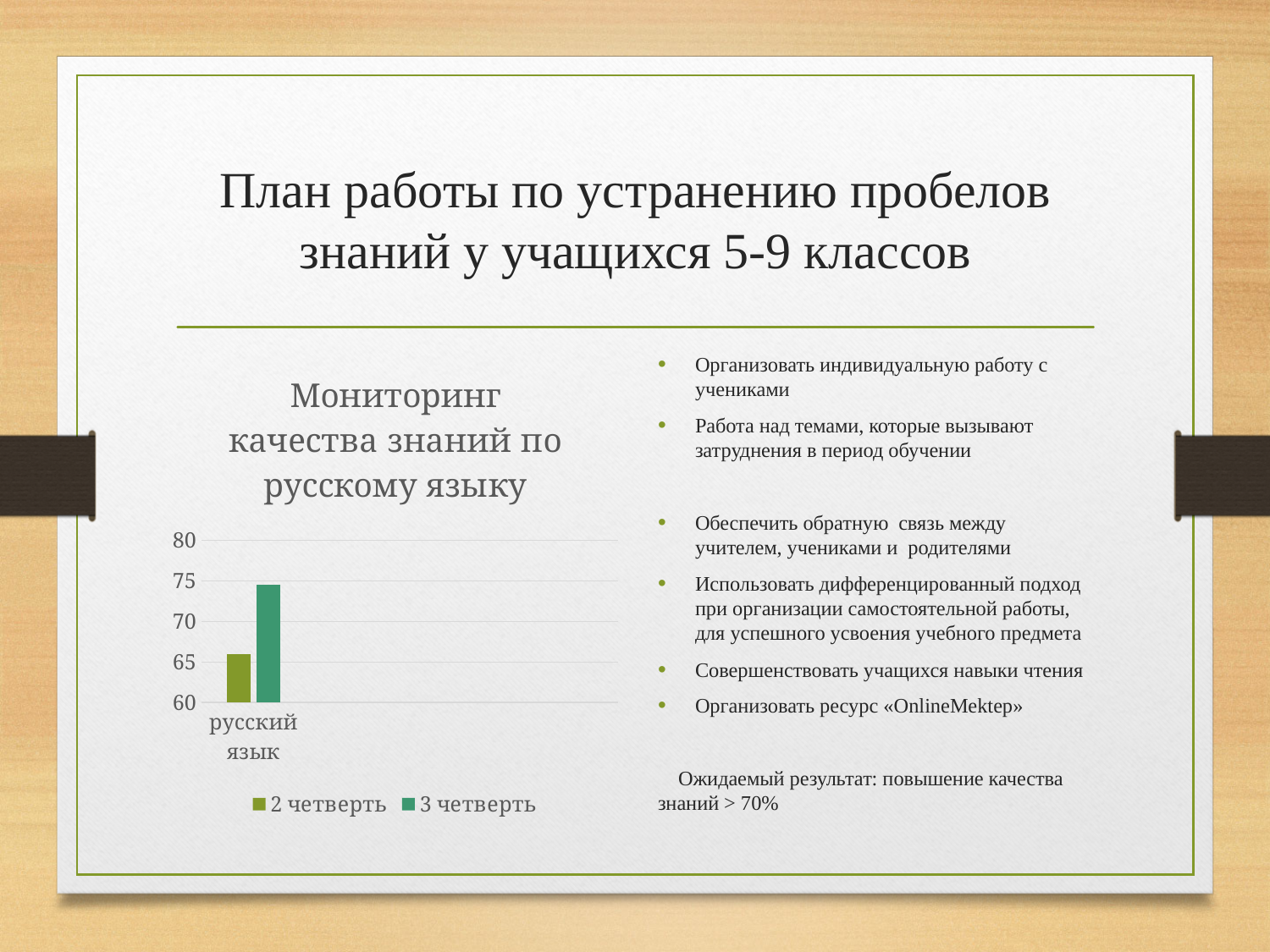
Which series has the lowest value for русский язык? 2 четверть What is the title of the chart? Мониторинг качества знаний по русскому языку What are the series names listed in the chart legend? 2 четверть, 3 четверть How many categories are shown on the x axis of the chart? 1 Which series has the higher value for русский язык: 2 четверть or 3 четверть? 3 четверть Is the value for 3 четверть greater or less than 70? greater Does the value for русский язык rise or fall from 2 четверть to 3 четверть? rise What kind of chart is shown on the slide? bar chart Is the value for 2 четверть greater or less than 70? less How many series does the chart legend list? 2